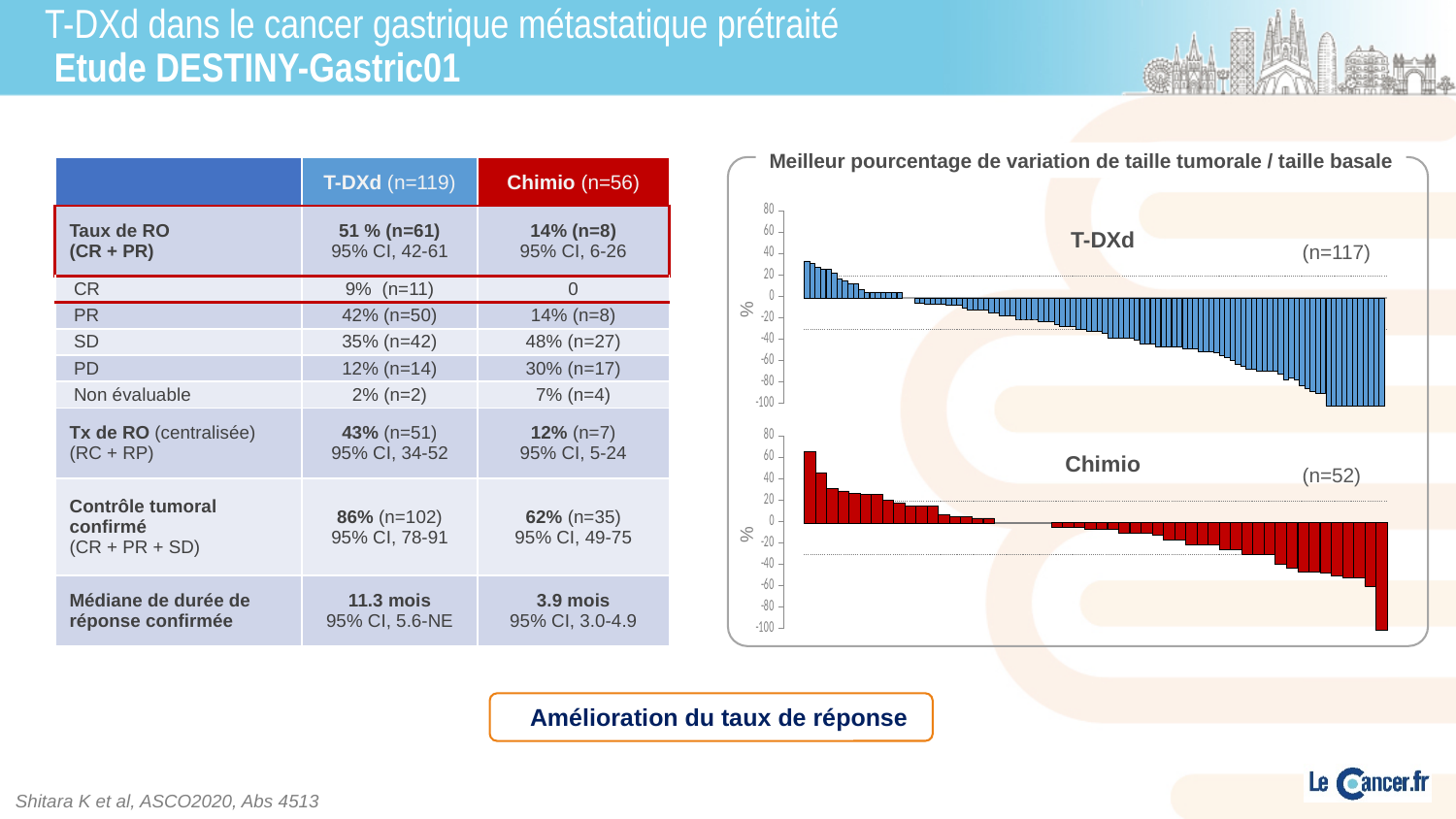
In the Chimio chart, how many patients are shown (n)? 52 In the T-DXd chart, how many patients are shown (n)? 117 What is the title of the chart panel on the right of the slide? Meilleur pourcentage de variation de taille tumorale / taille basale In the Chimio chart, do the bar values rise or fall from left to right? fall In the Chimio chart, is the largest positive change greater or less than 40? greater In the Chimio chart, is the lowest value greater or less than -80? less What colour are the bars in the T-DXd chart? blue What kind of chart is used to show the best percentage change in tumour size for T-DXd and Chimio? bar chart In the T-DXd chart, do the bar values rise or fall from left to right? fall In the T-DXd chart, is the largest positive change greater or less than 20? greater Which chart includes more patients, T-DXd or Chimio? T-DXd